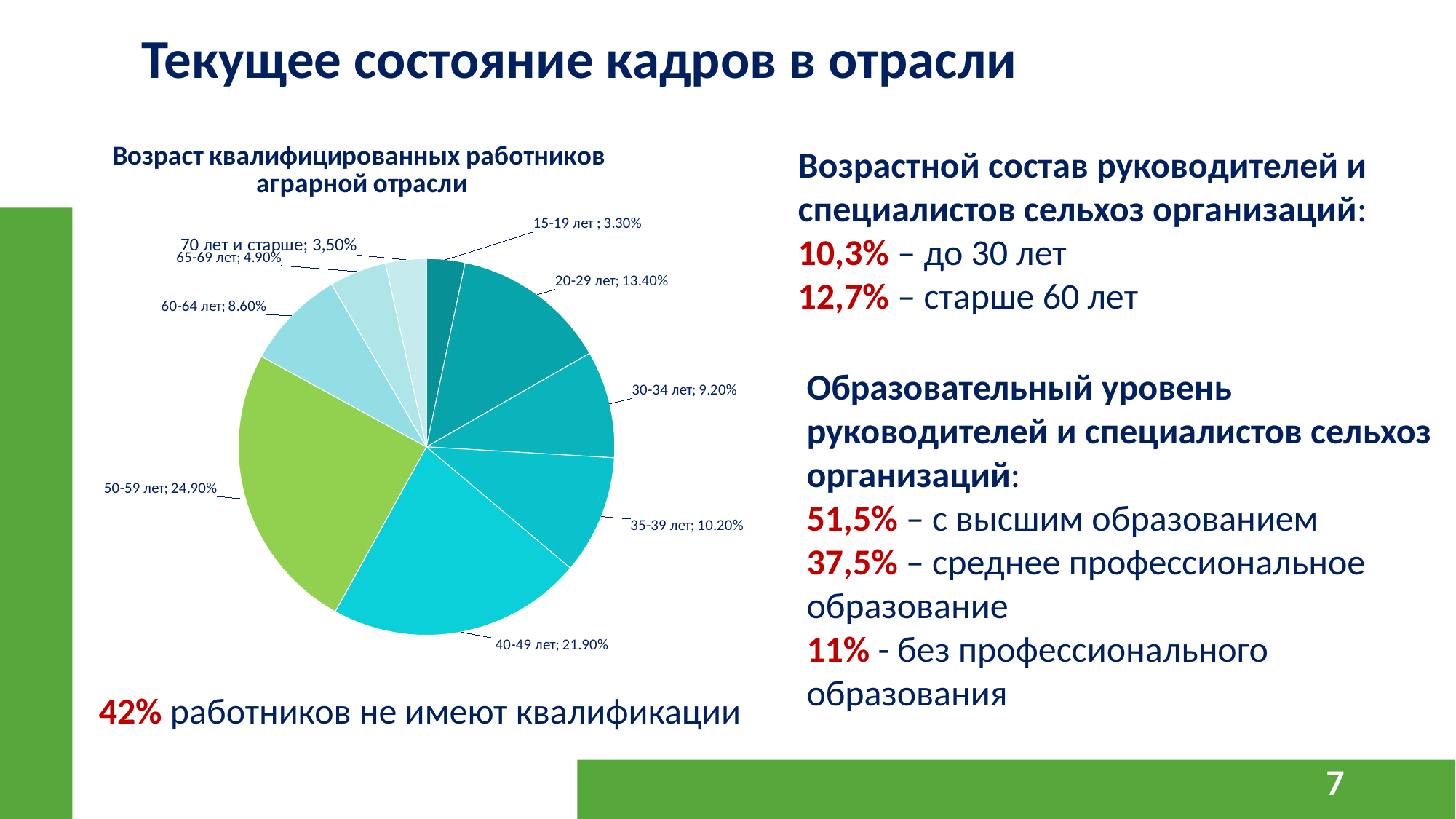
What is the value shown for the 70 лет и старше category? 3,50% Which age category has the smallest share in the pie chart? 15-19 лет What share of the pie chart is the 50-59 лет slice? 24.90% How many age categories (slices) does the pie chart have? 9 Which age category has the largest share in the pie chart? 50-59 лет What is the value shown for the 60-64 лет category? 8.60% What is the value shown for the 40-49 лет category? 21.90% What is the value shown for the 20-29 лет category? 13.40% What is the title of the pie chart? Возраст квалифицированных работников аграрной отрасли What kind of chart is shown on the slide? Pie chart What is the difference between the shares of 50-59 лет and 40-49 лет? 3.00% Which is larger, the share for 35-39 лет or the share for 30-34 лет? 35-39 лет